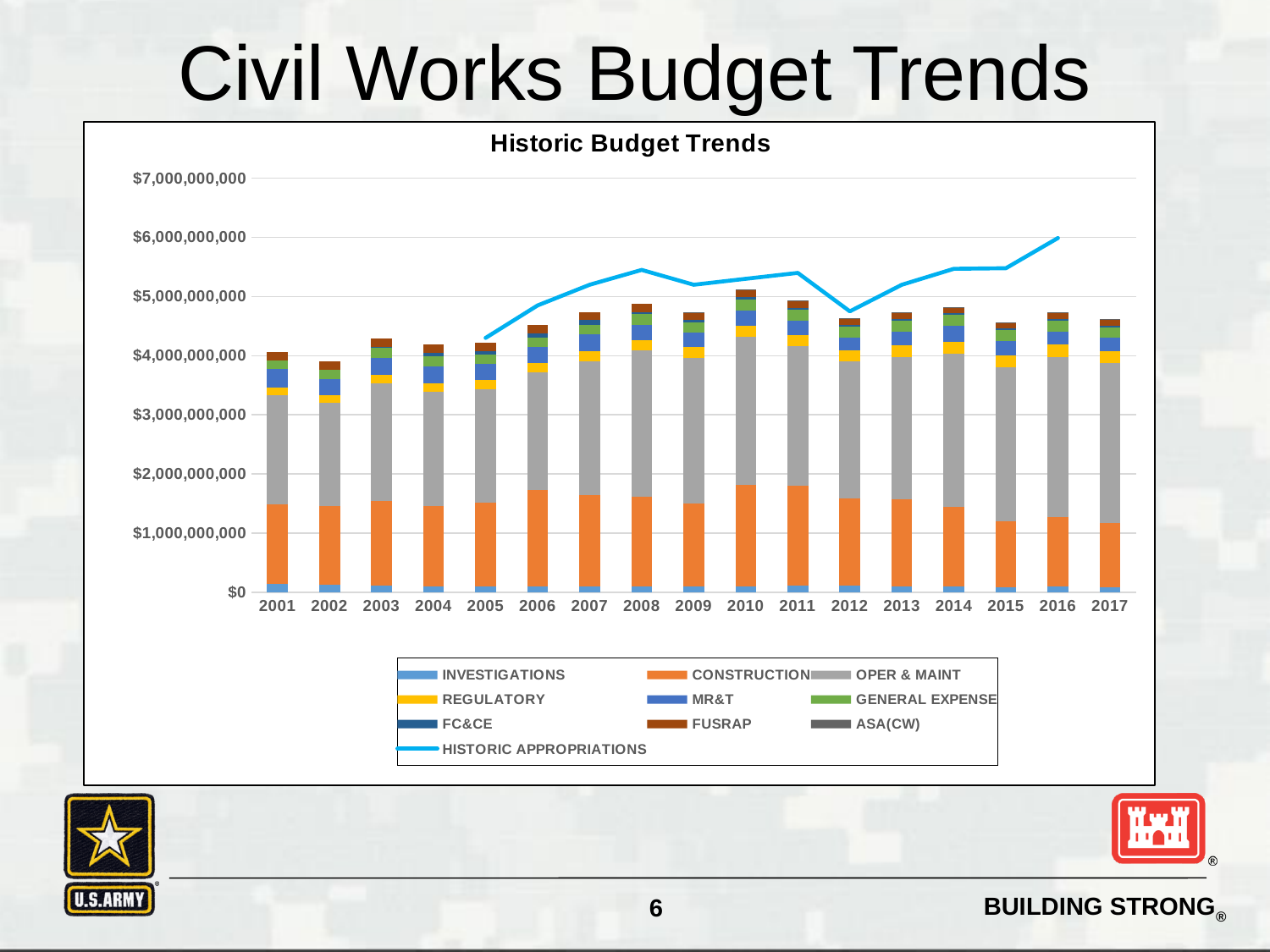
How many series does the chart's legend list? 10 Which series is shown in orange in the chart? CONSTRUCTION How many years are shown on the x axis of the chart? 17 Is the HISTORIC APPROPRIATIONS value for 2008 greater or less than $5,000,000,000? greater Does the HISTORIC APPROPRIATIONS line rise or fall from 2012 to 2016? rise Which year has the highest point on the HISTORIC APPROPRIATIONS line? 2016 Is the HISTORIC APPROPRIATIONS value for 2012 greater or less than $5,000,000,000? less Is the total of the stacked bar for 2017 greater or less than $5,000,000,000? less Which year has the larger CONSTRUCTION segment, 2010 or 2017? 2010 What is the title of the chart? Historic Budget Trends Which year has the tallest stacked bar? 2010 What kind of chart is shown on the slide? stacked bar chart with a line